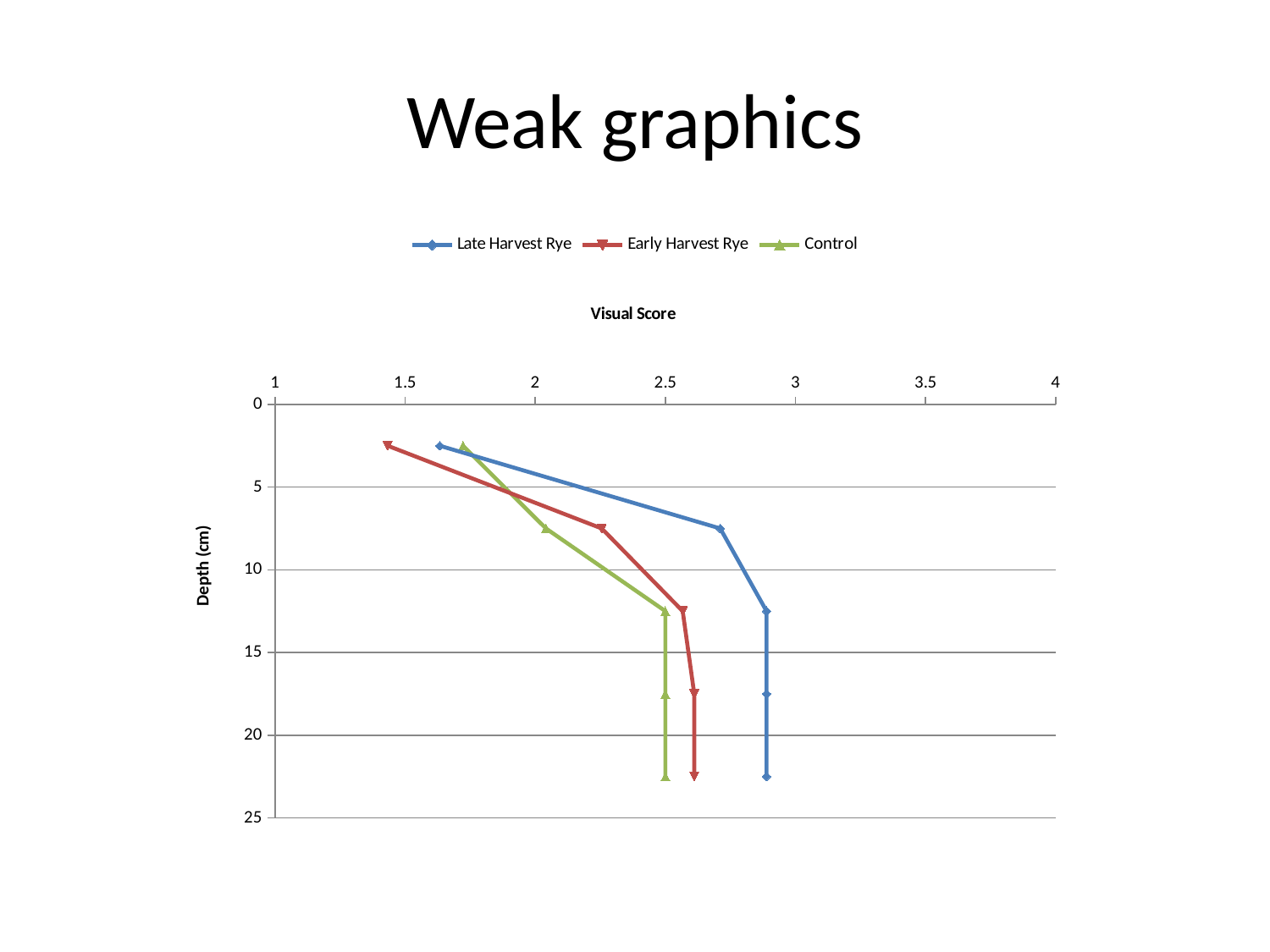
How many series does the legend list? 3 What is the label of the vertical axis? Depth (cm) For the Late Harvest Rye series, does the Visual Score rise or fall as depth increases from 2.5 cm to 12.5 cm? rise What kind of chart is shown on the slide? line chart At a depth of 7.5 cm, which series has the lowest Visual Score? Control Is the Visual Score for Late Harvest Rye at a depth of 22.5 cm greater or less than 2.5? greater What are the names of the three series in the legend? Late Harvest Rye, Early Harvest Rye, Control How many data points are plotted for the Late Harvest Rye series? 5 Is the Visual Score for Control at a depth of 7.5 cm greater or less than 2.5? less At a depth of 22.5 cm, which series has the higher Visual Score, Late Harvest Rye or Control? Late Harvest Rye Is the Visual Score for Early Harvest Rye at a depth of 2.5 cm greater or less than 1.5? less